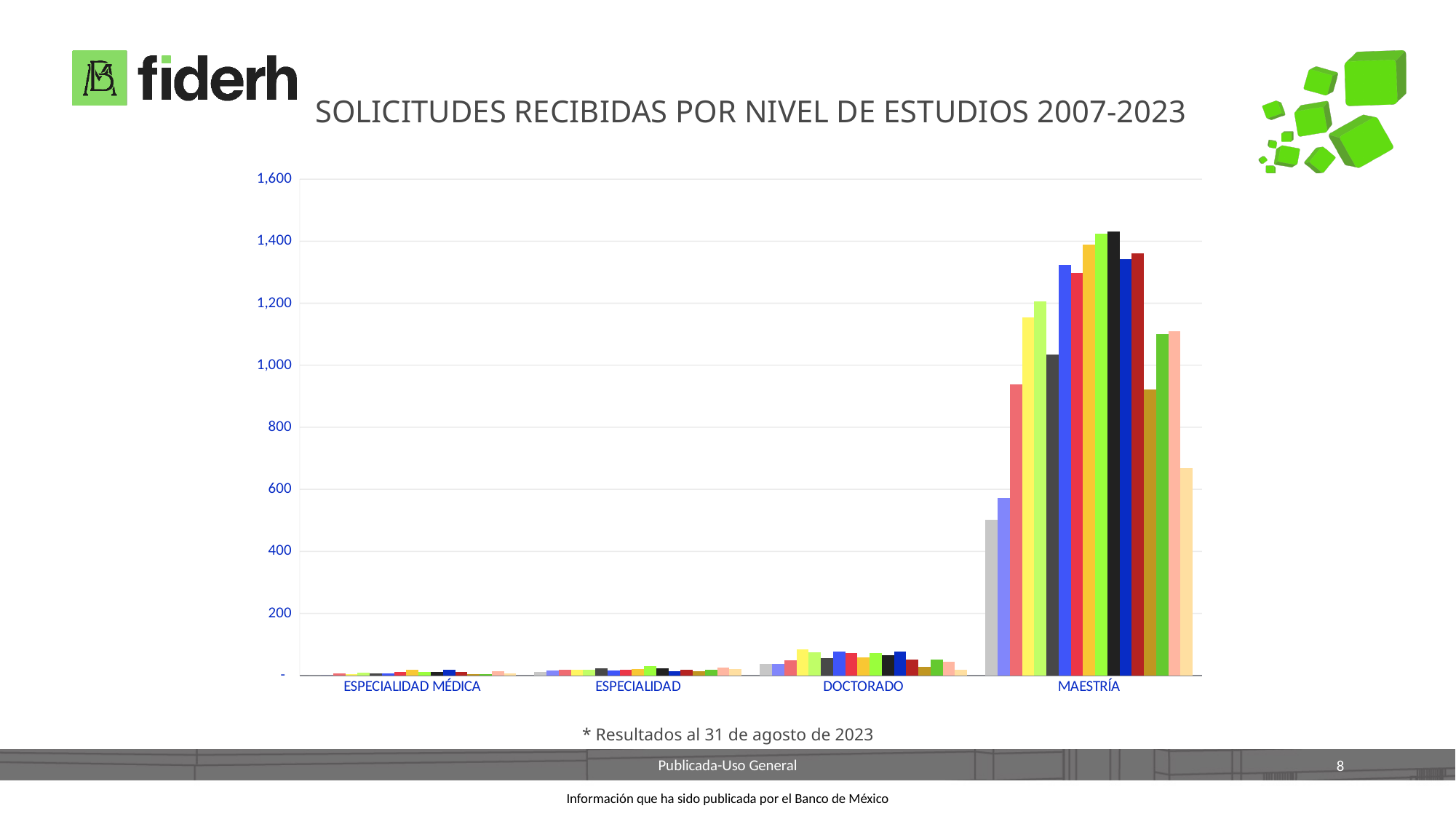
Do the values generally rise or fall moving from left to right across the categories? rise Which category has larger values, DOCTORADO or ESPECIALIDAD? DOCTORADO Which category has the highest bars? MAESTRÍA What kind of chart is shown on the slide? bar chart What is the highest value shown on the vertical axis? 1,600 Which category has the lowest bars? ESPECIALIDAD MÉDICA Is the shortest bar for MAESTRÍA greater or less than 400? greater Is the tallest bar for MAESTRÍA greater or less than 1,200? greater Are the bars for ESPECIALIDAD greater or less than 200? less How many study-level categories are shown on the x axis? 4 What is the title of the chart? SOLICITUDES RECIBIDAS POR NIVEL DE ESTUDIOS 2007-2023